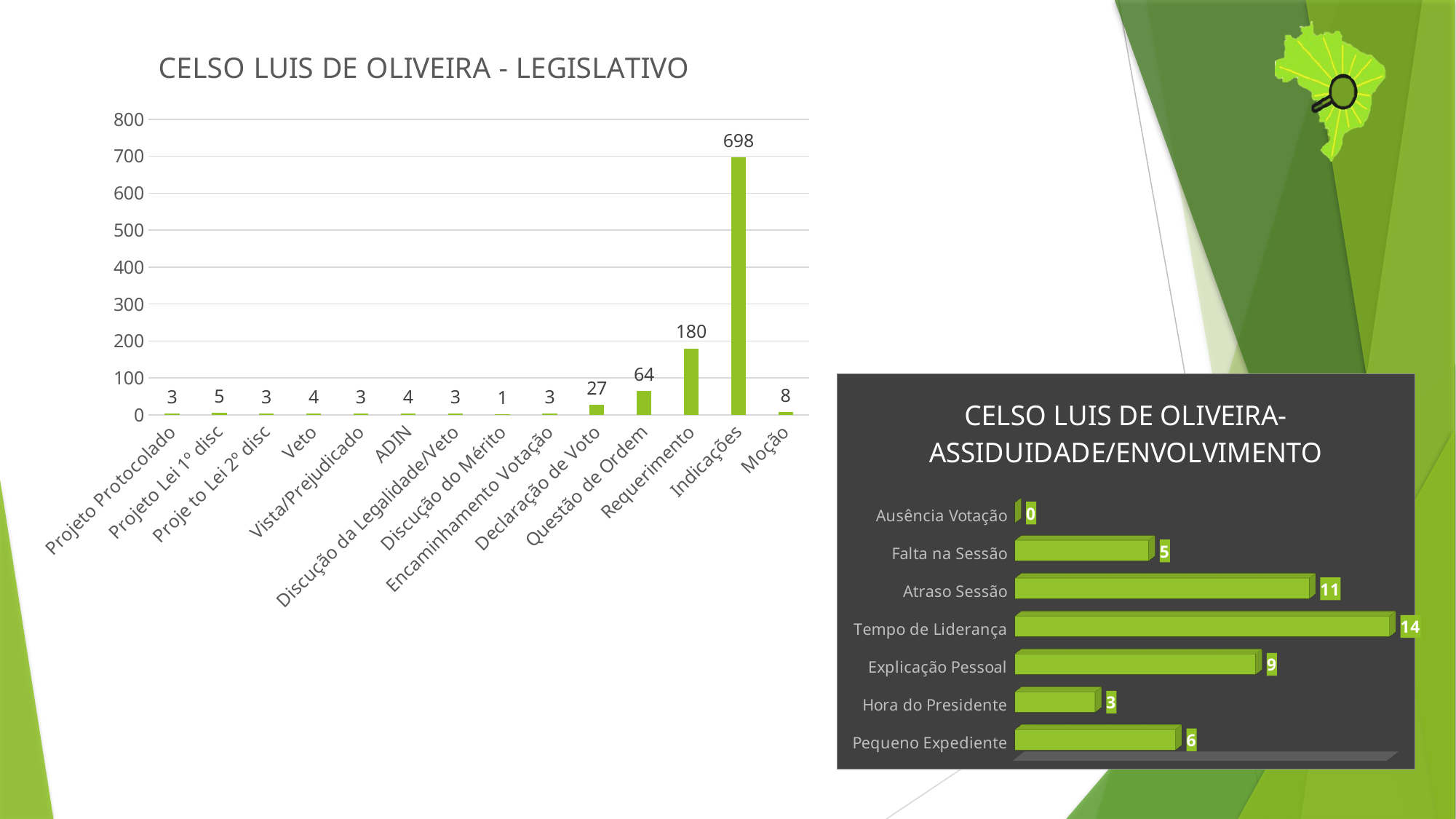
In the 'CELSO LUIS DE OLIVEIRA - LEGISLATIVO' chart, what is the value for Requerimento? 180 In the 'CELSO LUIS DE OLIVEIRA - LEGISLATIVO' chart, is the value for Questão de Ordem greater or less than 100? less In the 'CELSO LUIS DE OLIVEIRA- ASSIDUIDADE/ENVOLVIMENTO' chart, what is the value for Atraso Sessão? 11 What kind of chart is the 'CELSO LUIS DE OLIVEIRA- ASSIDUIDADE/ENVOLVIMENTO' chart? Bar chart In the 'CELSO LUIS DE OLIVEIRA - LEGISLATIVO' chart, which category has the highest value? Indicações In the 'CELSO LUIS DE OLIVEIRA - LEGISLATIVO' chart, what is the difference between Indicações and Requerimento? 518 In the 'CELSO LUIS DE OLIVEIRA - LEGISLATIVO' chart, what is the value for Indicações? 698 In the 'CELSO LUIS DE OLIVEIRA- ASSIDUIDADE/ENVOLVIMENTO' chart, which category has the highest value? Tempo de Liderança In the 'CELSO LUIS DE OLIVEIRA - LEGISLATIVO' chart, how many categories are shown on the x axis? 14 In the 'CELSO LUIS DE OLIVEIRA- ASSIDUIDADE/ENVOLVIMENTO' chart, how many categories are shown? 7 In the 'CELSO LUIS DE OLIVEIRA- ASSIDUIDADE/ENVOLVIMENTO' chart, which is larger, Explicação Pessoal or Pequeno Expediente? Explicação Pessoal In the 'CELSO LUIS DE OLIVEIRA - LEGISLATIVO' chart, which category has the lowest value? Discução do Mérito